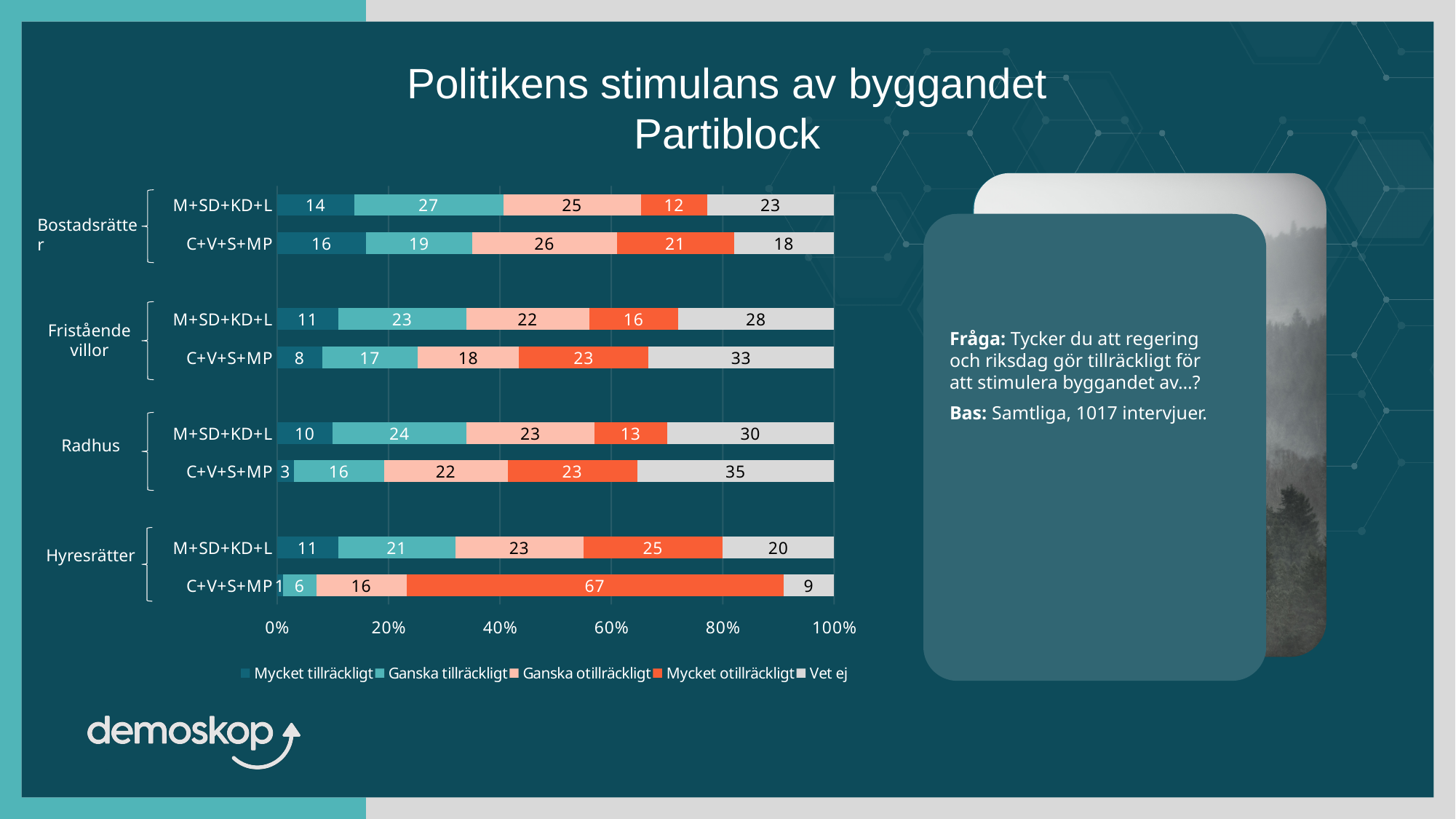
How many series does the legend list? 5 What is the value of "Mycket otillräckligt" for C+V+S+MP under Hyresrätter? 67 Which bar has the highest "Mycket otillräckligt" value? C+V+S+MP under Hyresrätter How many bars are plotted in the chart? 8 What is the value of "Mycket tillräckligt" for C+V+S+MP under Fristående villor? 8 What is the difference between the "Vet ej" values for M+SD+KD+L and C+V+S+MP under Fristående villor? 5 What is the value of "Vet ej" for C+V+S+MP under Radhus? 35 Which bar has the lowest "Mycket tillräckligt" value? C+V+S+MP under Hyresrätter What is the value of "Ganska tillräckligt" for M+SD+KD+L under Bostadsrätter? 27 Under Bostadsrätter, which has the larger "Mycket otillräckligt" value, M+SD+KD+L or C+V+S+MP? C+V+S+MP What kind of chart is shown on the slide? Stacked bar chart What is the total of the segments in the C+V+S+MP bar under Hyresrätter? 99